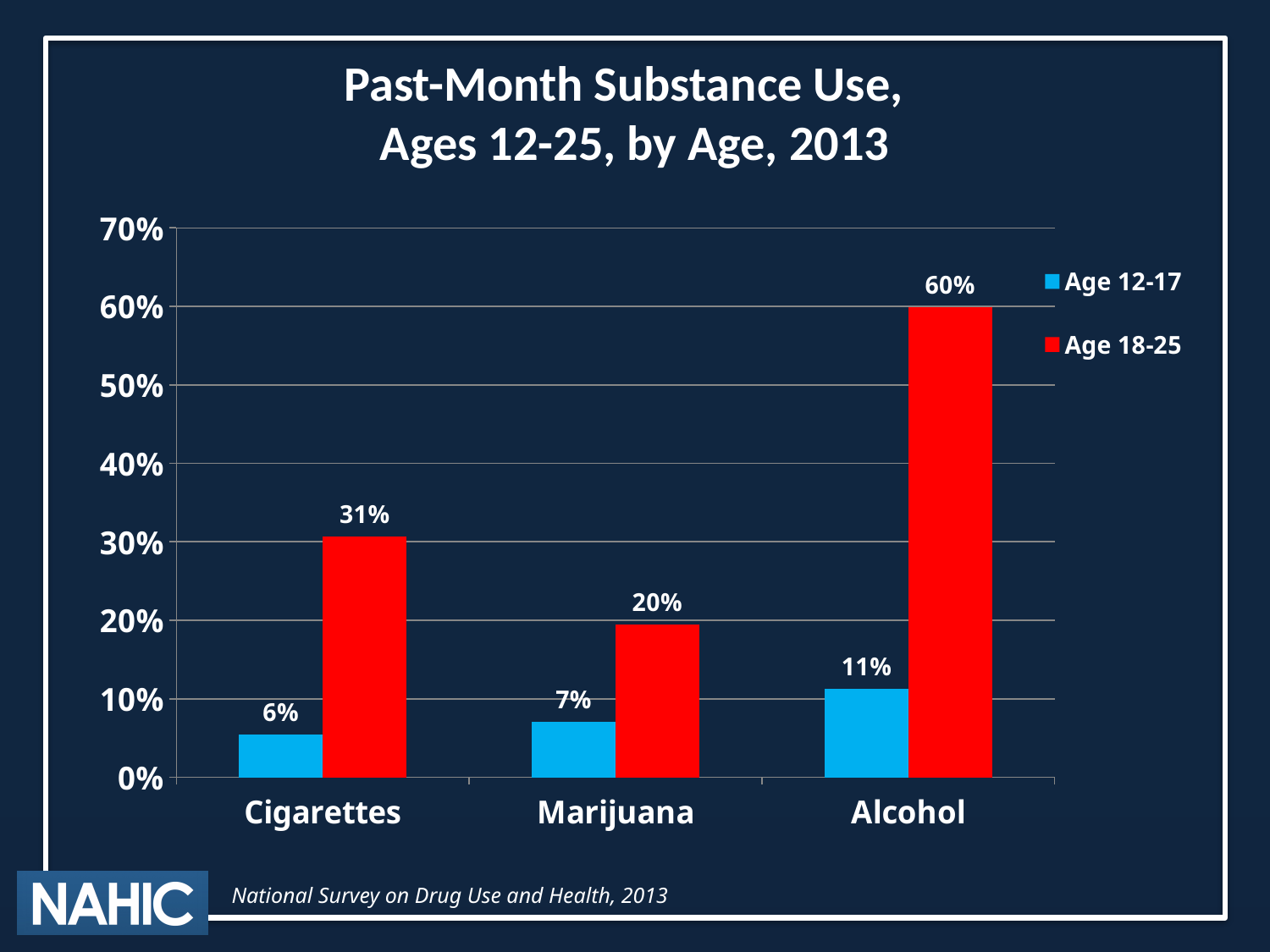
Is the Age 18-25 value for Cigarettes greater or less than 40%? less What is the difference between the Age 18-25 values for Cigarettes and Marijuana? 11% What is the past-month cigarette use value for Age 12-17? 6% How many series does the legend list? 2 What is the past-month marijuana use value for Age 18-25? 20% What is the difference between the Age 18-25 and Age 12-17 values for Alcohol? 49% Which is larger: the Age 12-17 value for Alcohol or the Age 12-17 value for Marijuana? Alcohol How many substance categories are shown on the x axis? 3 What is the past-month alcohol use value for Age 18-25? 60% What kind of chart is shown on the slide? Bar chart Which substance has the lowest past-month use among Age 12-17? Cigarettes Which substance has the highest past-month use among Age 18-25? Alcohol